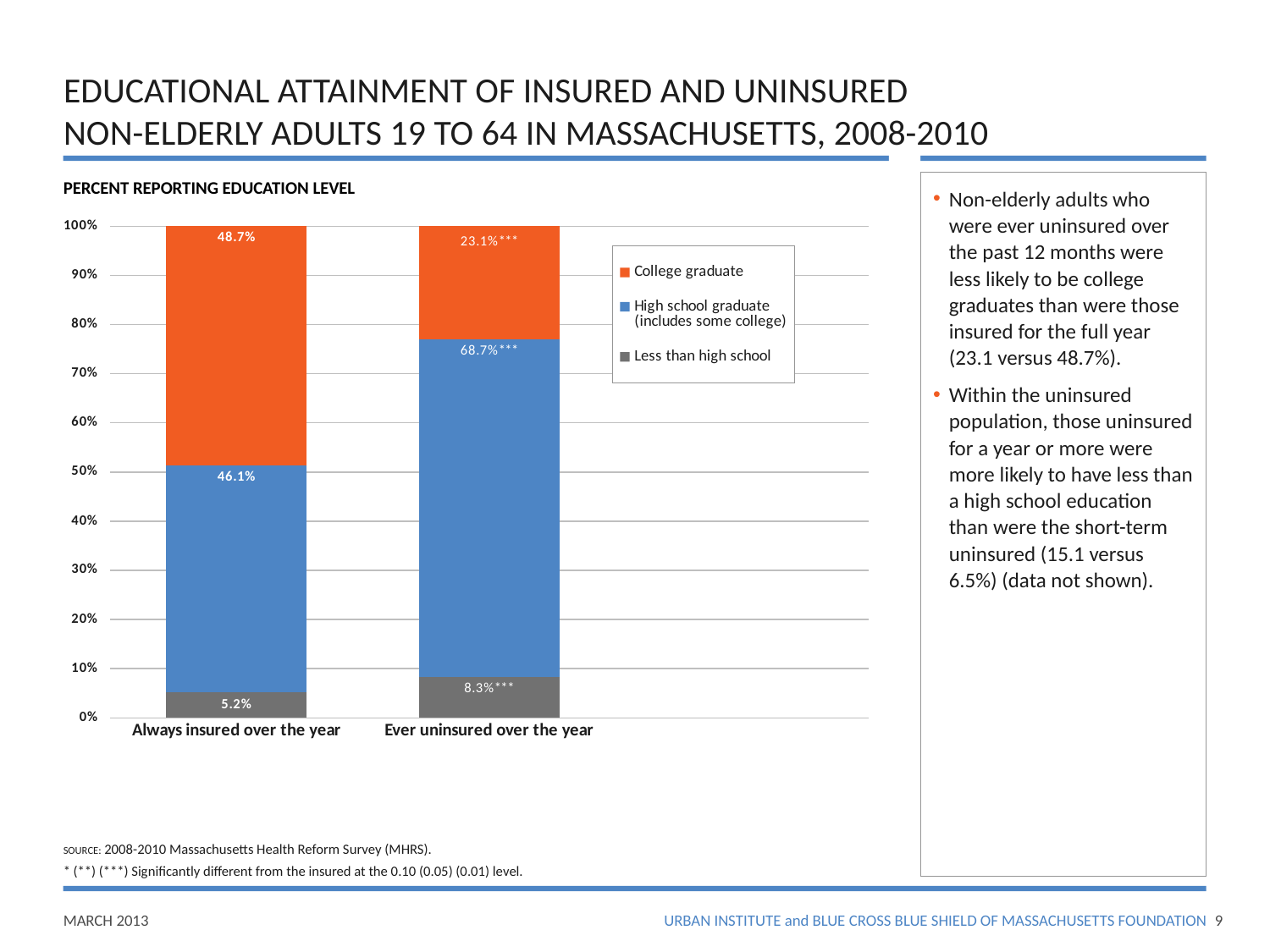
Which group has the higher share of college graduates, always insured or ever uninsured over the year? Always insured over the year What percentage of adults ever uninsured over the year have less than high school education? 8.3% Which colour represents college graduates in the chart? Orange How many categories are shown on the x axis? 2 What percentage of adults always insured over the year have less than high school education? 5.2% How many series does the legend list? 3 What is the difference in the high school graduate share between the ever uninsured and always insured groups? 22.6 percentage points What is the difference in the college graduate share between the always insured and ever uninsured groups? 25.6 percentage points What percentage of adults ever uninsured over the year are college graduates? 23.1% What percentage of adults always insured over the year are college graduates? 48.7% What kind of chart is shown on the slide? Stacked bar chart What percentage of adults ever uninsured over the year are high school graduates (includes some college)? 68.7%